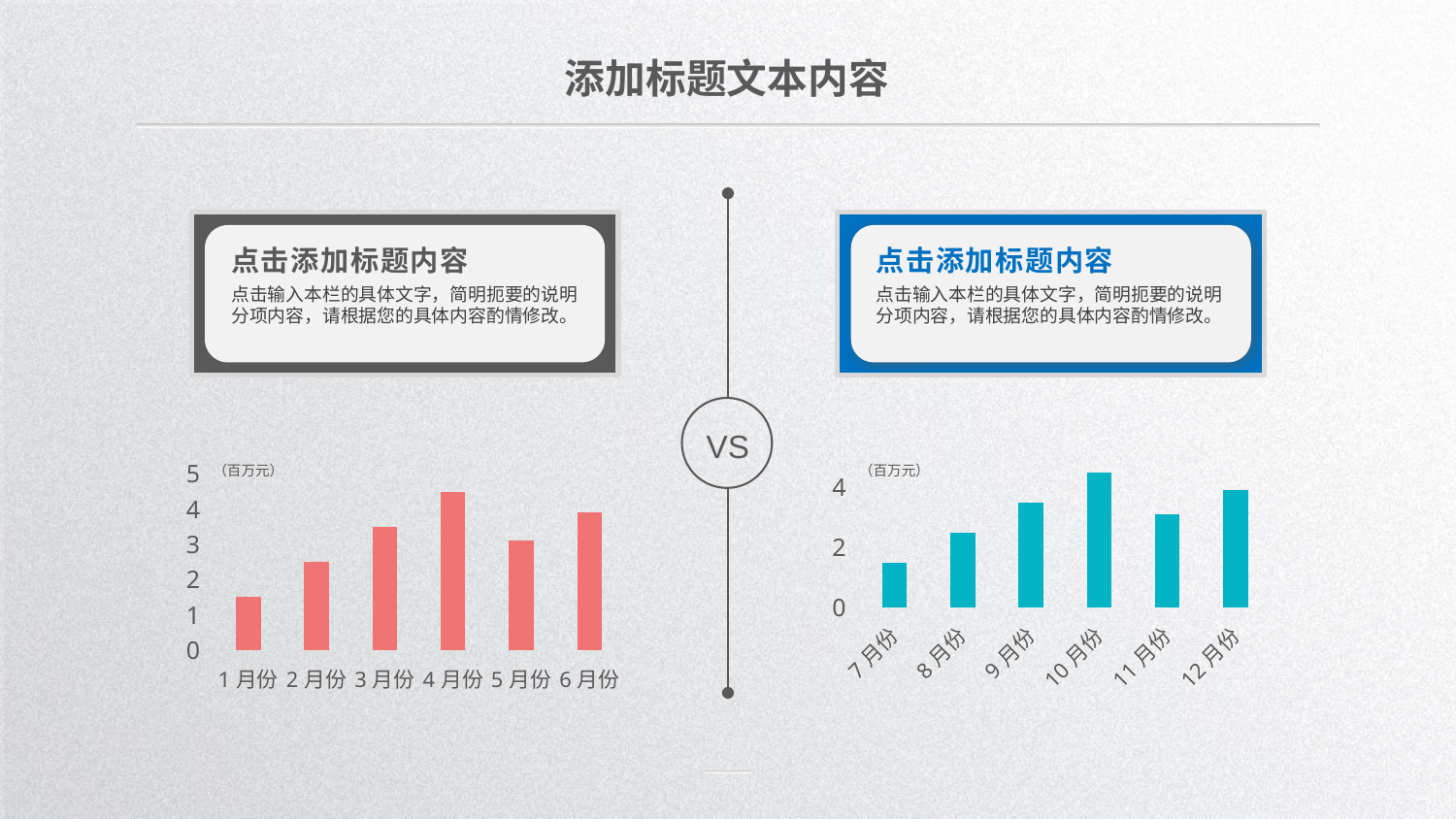
In the left chart, is the value for 1月份 greater or less than 2? less How many categories does the right chart show? 6 In the right chart, which month has the lowest bar? 7月份 What unit is shown at the top of the axis in the left chart? 百万元 In the left chart, which month has the lowest bar? 1月份 In the left chart, which is larger, the bar for 3月份 or the bar for 5月份? 3月份 What kind of chart is the right chart? bar chart In the right chart, is the value for 10月份 greater or less than 4? greater In the right chart, which month has the highest bar? 10月份 In the left chart, which month has the highest bar? 4月份 How many categories does the left chart show? 6 What kind of chart is the left chart? bar chart